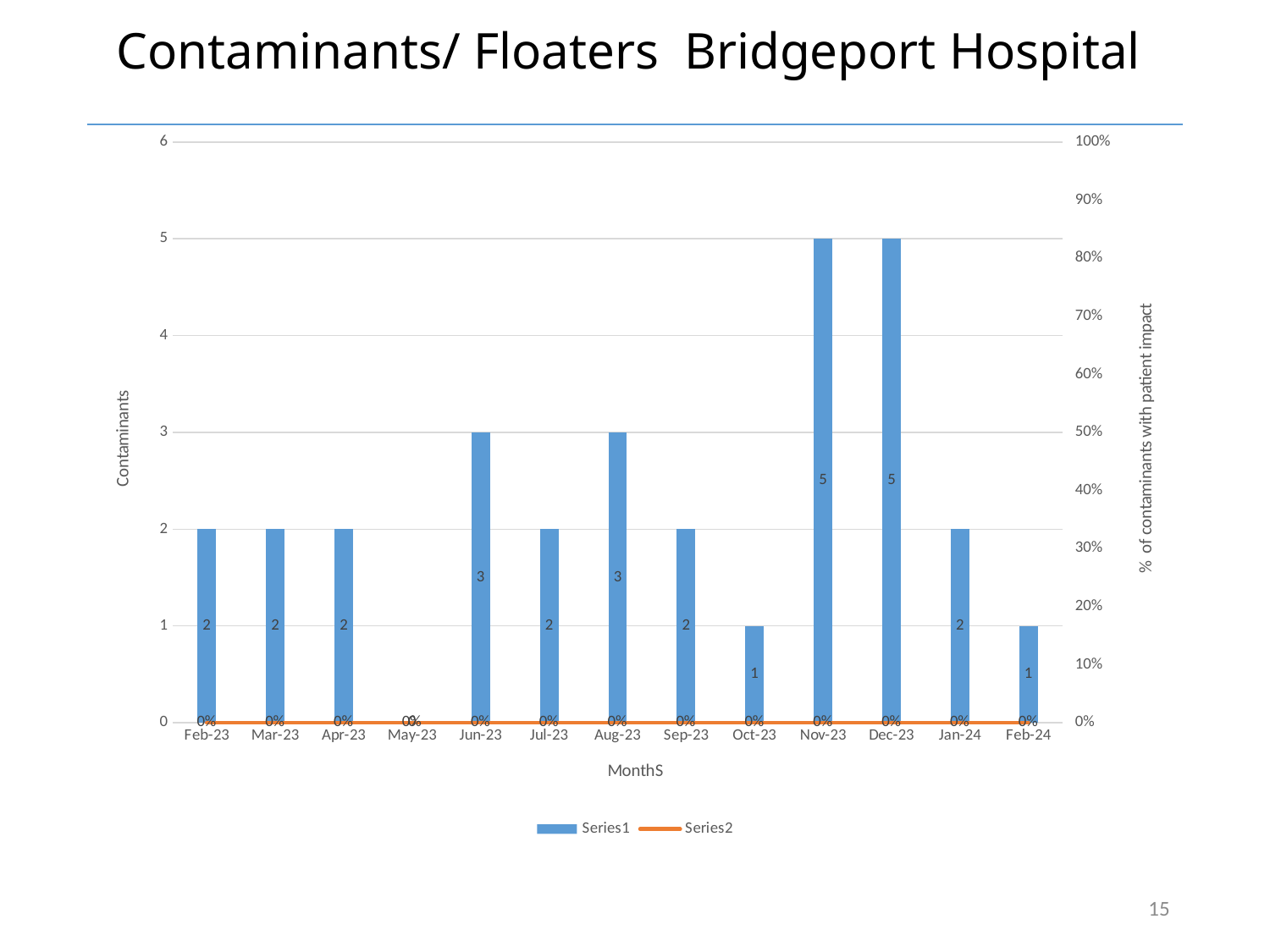
What kind of chart is used to show the contaminants by month? Bar chart What is the value for Jun-23 in the Contaminants/ Floaters Bridgeport Hospital chart? 3 What is the highest number of contaminants shown in the chart? 5 What is the value for Oct-23 in the chart? 1 What is the label of the right-hand vertical axis? % of contaminants with patient impact Which is larger, the value for Aug-23 or the value for Sep-23? Aug-23 What is the difference between the values for Dec-23 and Feb-24? 4 What is the value for Jan-24 in the chart? 2 How many series does the legend list? 2 What is the value for Nov-23 in the chart? 5 How many months are shown on the x axis of the chart? 13 Which month has the lowest number of contaminants in the chart? May-23